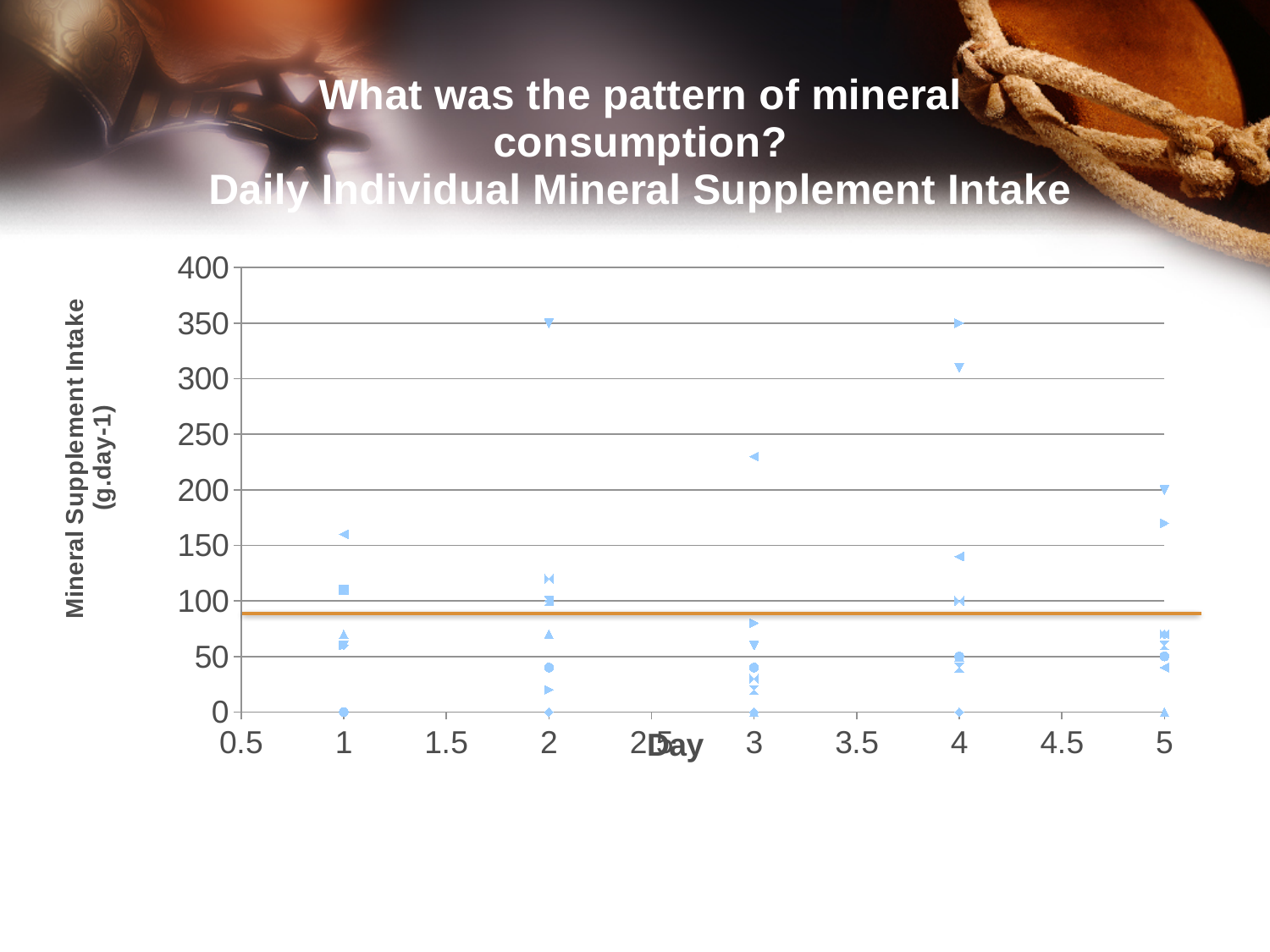
Is the highest point plotted for day 1 greater or less than 200? less Is the highest point plotted for day 4 greater or less than 300? greater Is the highest point plotted for day 5 greater or less than 150? greater What kind of chart is shown on the slide? scatter chart Which day has the larger maximum intake value, day 2 or day 5? day 2 How many days are plotted on the x axis of the chart? 5 Which day has the lowest maximum intake value among the five days? day 1 What is the title of the chart on the slide? What was the pattern of mineral consumption? Daily Individual Mineral Supplement Intake What is the label of the vertical axis of the chart? Mineral Supplement Intake (g.day-1)